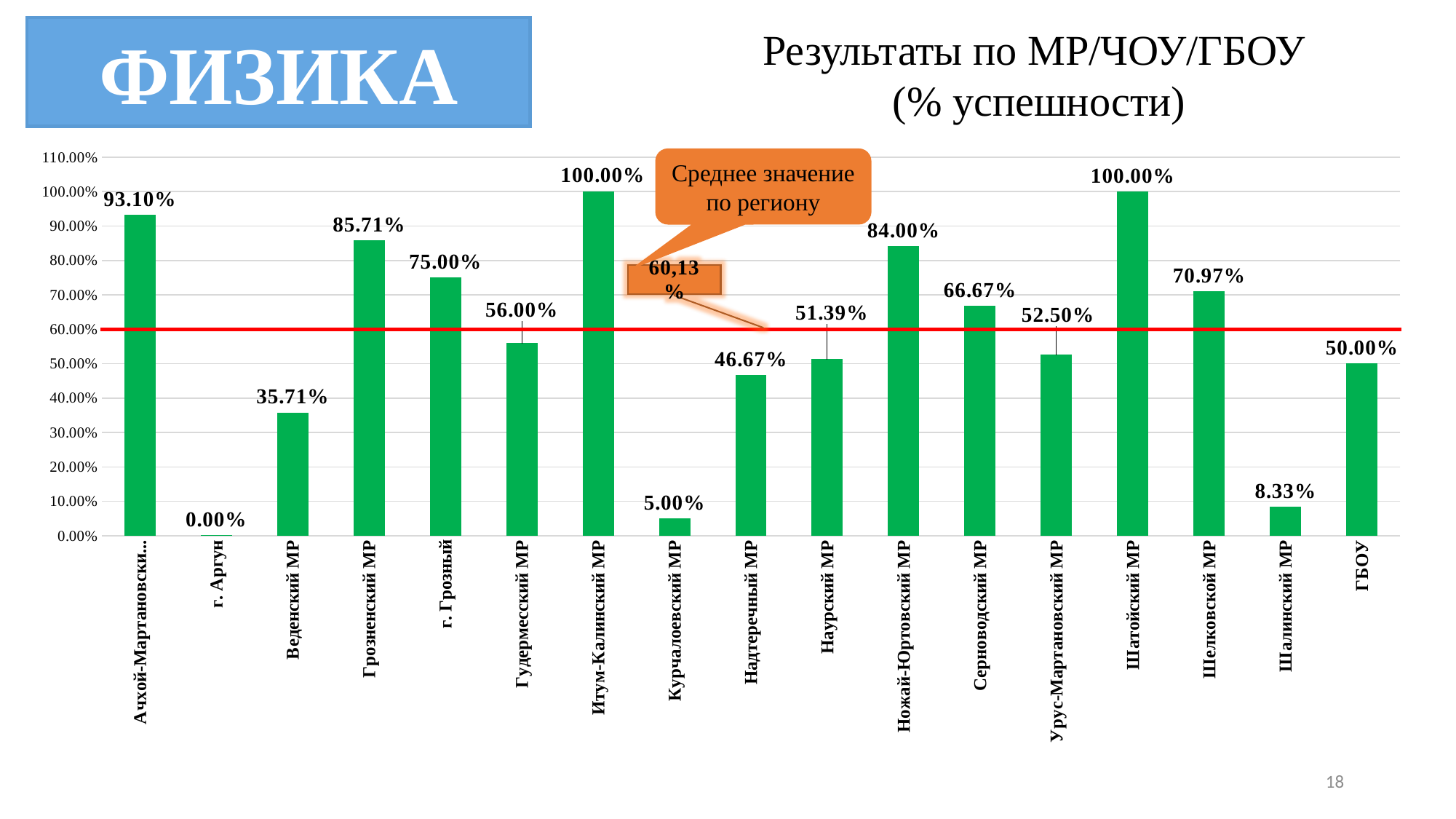
Which categories share the highest value of 100.00%? Итум-Калинский МР and Шатойский МР How many categories are shown on the x axis? 17 Which category has the lowest value? г. Аргун What is the value for Шелковской МР? 70.97% What is the title of the chart? Результаты по МР/ЧОУ/ГБОУ (% успешности) What is the value for ГБОУ? 50.00% What is the value for Грозненский МР? 85.71% What kind of chart is shown on the slide? Bar chart Which is larger, the value for Веденский МР or the value for Надтеречный МР? Надтеречный МР What is the difference between the values for Ножай-Юртовский МР and Наурский МР? 32.61% What is the regional average value (Среднее значение по региону) marked by the red line? 60,13% What is the value for Курчалоевский МР? 5.00%